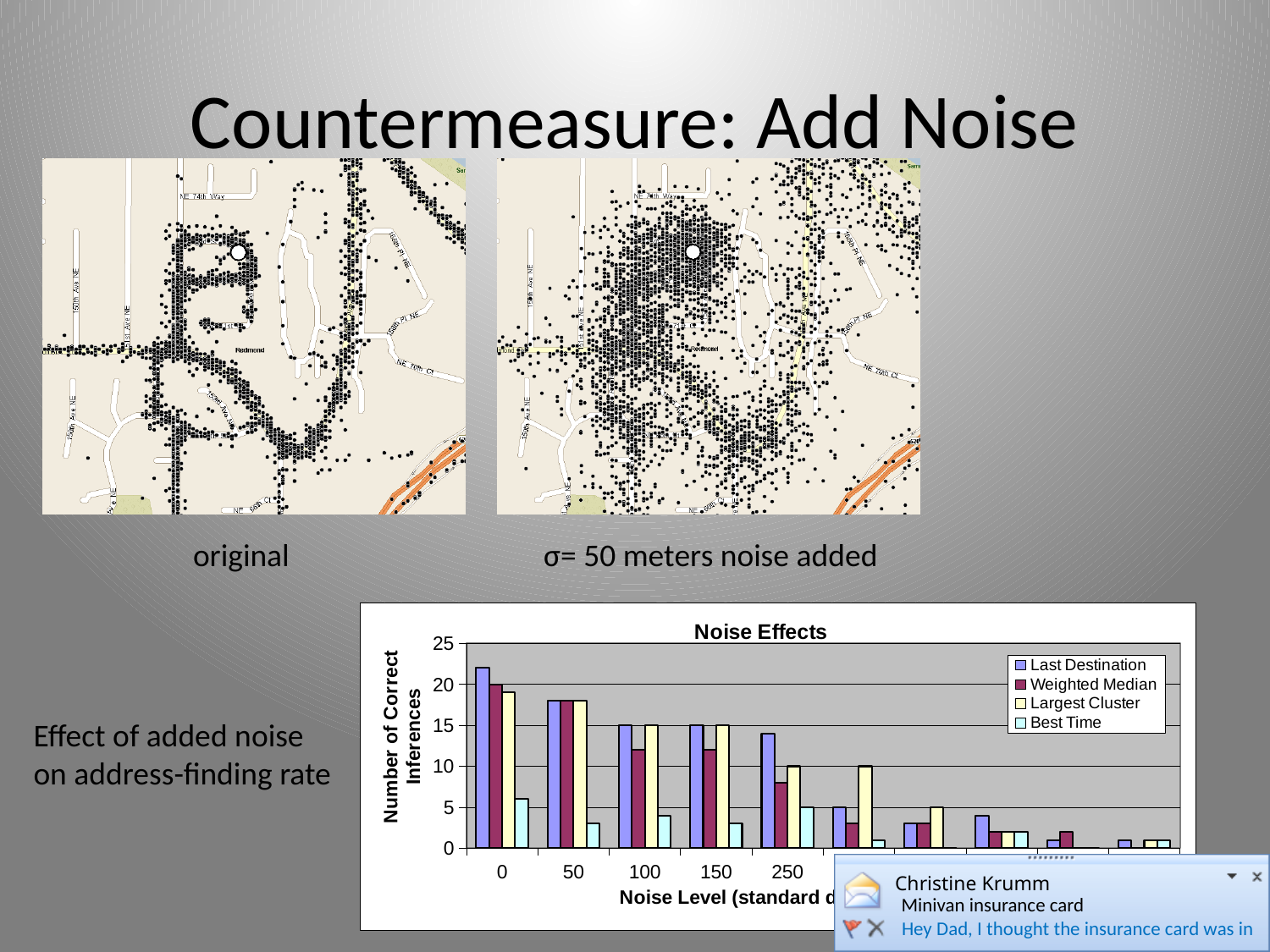
In the 'Noise Effects' chart, is the value for Weighted Median at noise level 250 greater or less than 10? less In the 'Noise Effects' chart, is the value for Best Time at noise level 0 greater or less than 5? greater How many series does the legend of the 'Noise Effects' chart list? 4 In the 'Noise Effects' chart, does the Last Destination series rise or fall as the noise level increases? fall What is the y-axis label of the 'Noise Effects' chart? Number of Correct Inferences In the 'Noise Effects' chart, which series has the highest value at noise level 0? Last Destination What is the title of the chart at the bottom of the slide? Noise Effects In the 'Noise Effects' chart, is the value for Largest Cluster at noise level 50 greater or less than 15? greater What type of chart is the 'Noise Effects' chart? bar chart In the 'Noise Effects' chart, which series has the lowest value at noise level 0? Best Time In the 'Noise Effects' chart, at noise level 250, which is larger: Last Destination or Weighted Median? Last Destination